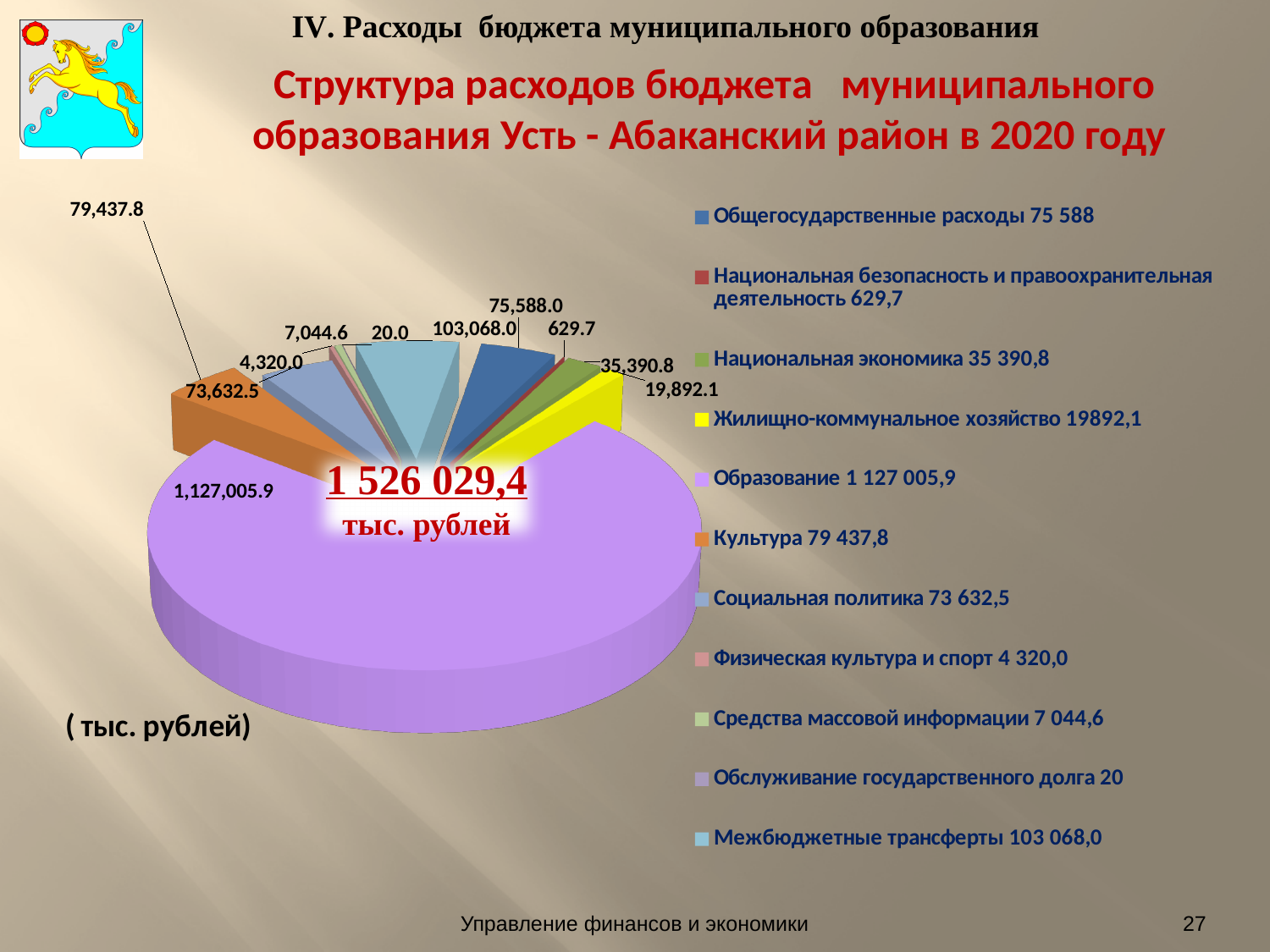
What is the value for Национальная безопасность и правоохранительная деятельность? 629.7 What is the difference between Межбюджетные трансферты and Общегосударственные расходы? 27,480.0 Which is larger, Культура or Социальная политика? Культура What is the value for Жилищно-коммунальное хозяйство? 19,892.1 Which category has the largest value? Образование Which category has the smallest value? Обслуживание государственного долга What kind of chart is shown on the slide? pie chart What is the value for Межбюджетные трансферты? 103,068.0 What is the value for Образование? 1,127,005.9 How many categories does the pie chart have? 11 What total value is printed in the centre of the pie chart? 1 526 029,4 тыс. рублей What share of the total 1 526 029,4 does Образование (1,127,005.9) represent? 73.9%